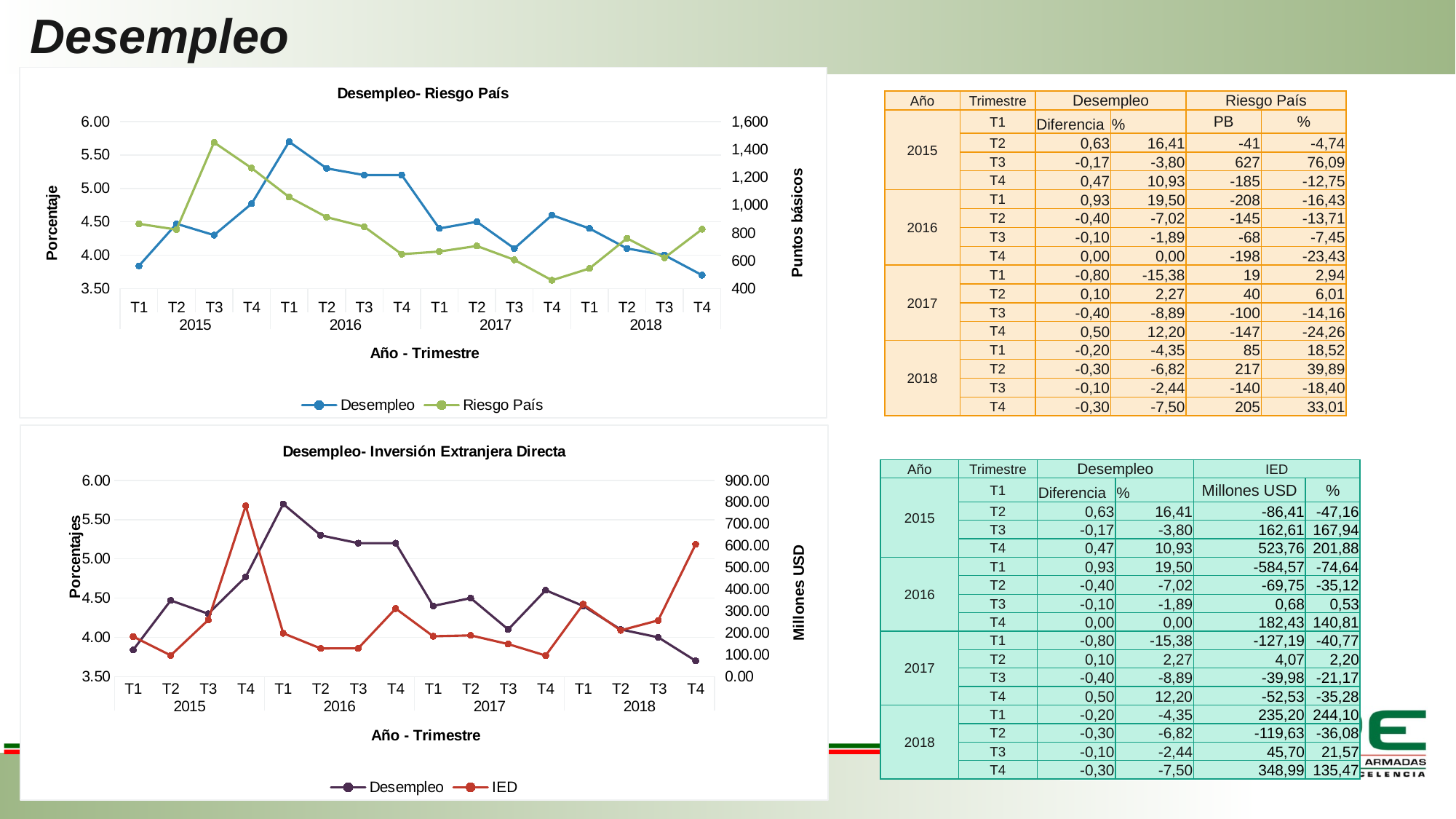
In the 'Desempleo- Riesgo País' chart, in which quarter does the Desempleo series reach its highest value? T1 2016 How many series does the legend of the 'Desempleo- Inversión Extranjera Directa' chart list? 2 In the 'Desempleo- Inversión Extranjera Directa' chart, does the Desempleo series generally rise or fall from T1 2016 to T4 2018? fall In the 'Desempleo- Riesgo País' chart, which is larger: the Riesgo País value for T3 2015 or for T4 2017? T3 2015 In the 'Desempleo- Inversión Extranjera Directa' chart, in which quarter does the IED series reach its highest value? T4 2015 How many quarterly points are plotted along the x axis of the 'Desempleo- Riesgo País' chart? 16 What type of chart is the 'Desempleo- Riesgo País' chart? line chart In the 'Desempleo- Riesgo País' chart, is the Desempleo value for T1 2016 greater or less than 5.50? greater In the 'Desempleo- Riesgo País' chart, is the Riesgo País value for T3 2015 greater or less than 1,200? greater In the 'Desempleo- Inversión Extranjera Directa' chart, is the IED value for T1 2016 greater or less than 300.00? less In the 'Desempleo- Riesgo País' chart, in which quarter does the Riesgo País series reach its highest value? T3 2015 In the 'Desempleo- Riesgo País' chart, in which quarter is the Desempleo series at its lowest? T4 2018